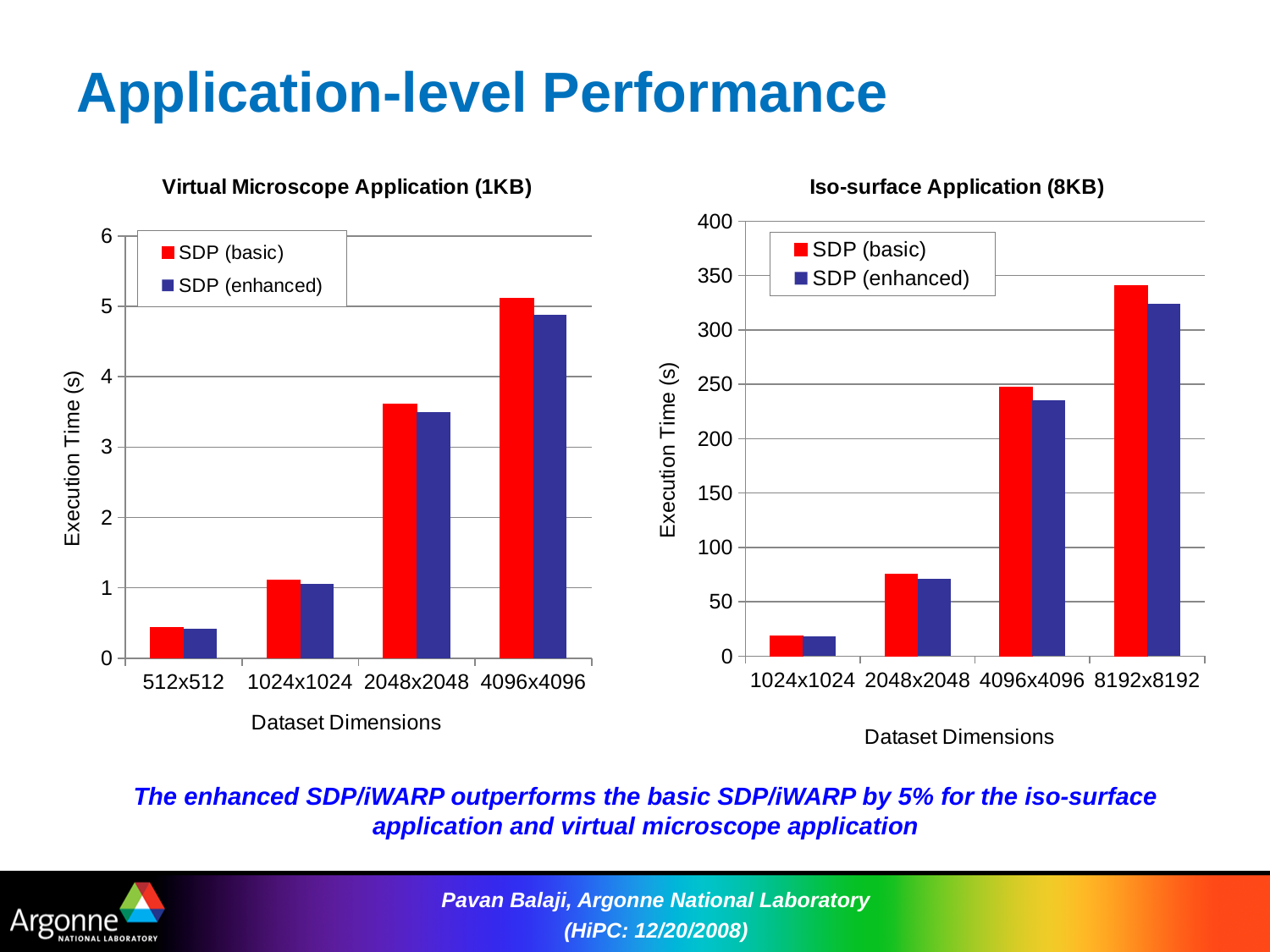
In the Virtual Microscope Application (1KB) chart, how many series does the legend list? 2 In the Iso-surface Application (8KB) chart, do execution times rise or fall as the dataset dimensions increase along the x axis? rise In the Iso-surface Application (8KB) chart, which is larger for 4096x4096: SDP (basic) or SDP (enhanced)? SDP (basic) In the Virtual Microscope Application (1KB) chart, which dataset dimension has the lowest execution time? 512x512 In the Virtual Microscope Application (1KB) chart, is the SDP (basic) value for 2048x2048 greater or less than 3? greater In the Iso-surface Application (8KB) chart, is the SDP (enhanced) value for 4096x4096 greater or less than 250? less In the Iso-surface Application (8KB) chart, which dataset dimension has the highest execution time? 8192x8192 What kind of chart is the Iso-surface Application (8KB) chart? bar chart In the Iso-surface Application (8KB) chart, is the SDP (basic) value for 8192x8192 greater or less than 300? greater In the Virtual Microscope Application (1KB) chart, which dataset dimension has the highest execution time? 4096x4096 In the Virtual Microscope Application (1KB) chart, how many dataset dimensions are shown on the x axis? 4